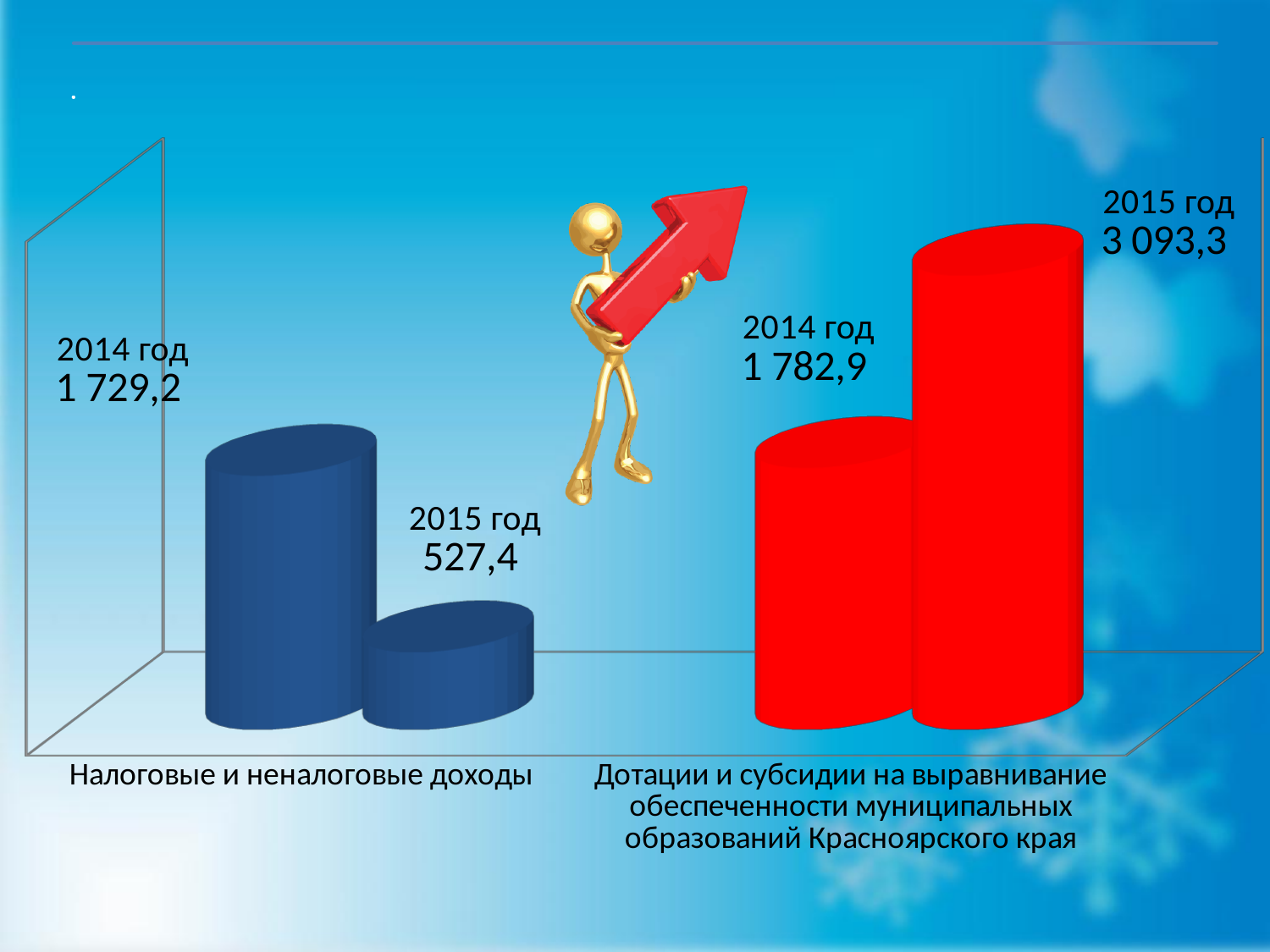
What is the value for 2014 год in the category Дотации и субсидии на выравнивание обеспеченности муниципальных образований Красноярского края? 1 782,9 What colour are the bars for the category Дотации и субсидии на выравнивание обеспеченности муниципальных образований Красноярского края? Red Which bar has the lowest value on the chart? 2015 год, Налоговые и неналоговые доходы By how much did the value for Дотации и субсидии на выравнивание обеспеченности муниципальных образований Красноярского края rise from 2014 год to 2015 год? 1 310,4 By how much did the value for Налоговые и неналоговые доходы fall from 2014 год to 2015 год? 1 201,9 How many categories are shown on the chart? 2 What is the value for 2014 год in the category Налоговые и неналоговые доходы? 1 729,2 What is the value for 2015 год in the category Налоговые и неналоговые доходы? 527,4 Which bar has the highest value on the chart? 2015 год, Дотации и субсидии на выравнивание обеспеченности муниципальных образований Красноярского края What kind of chart is shown on the slide? Bar chart Which is larger: the 2015 год value for Налоговые и неналоговые доходы or the 2015 год value for Дотации и субсидии? Дотации и субсидии What is the value for 2015 год in the category Дотации и субсидии на выравнивание обеспеченности муниципальных образований Красноярского края? 3 093,3